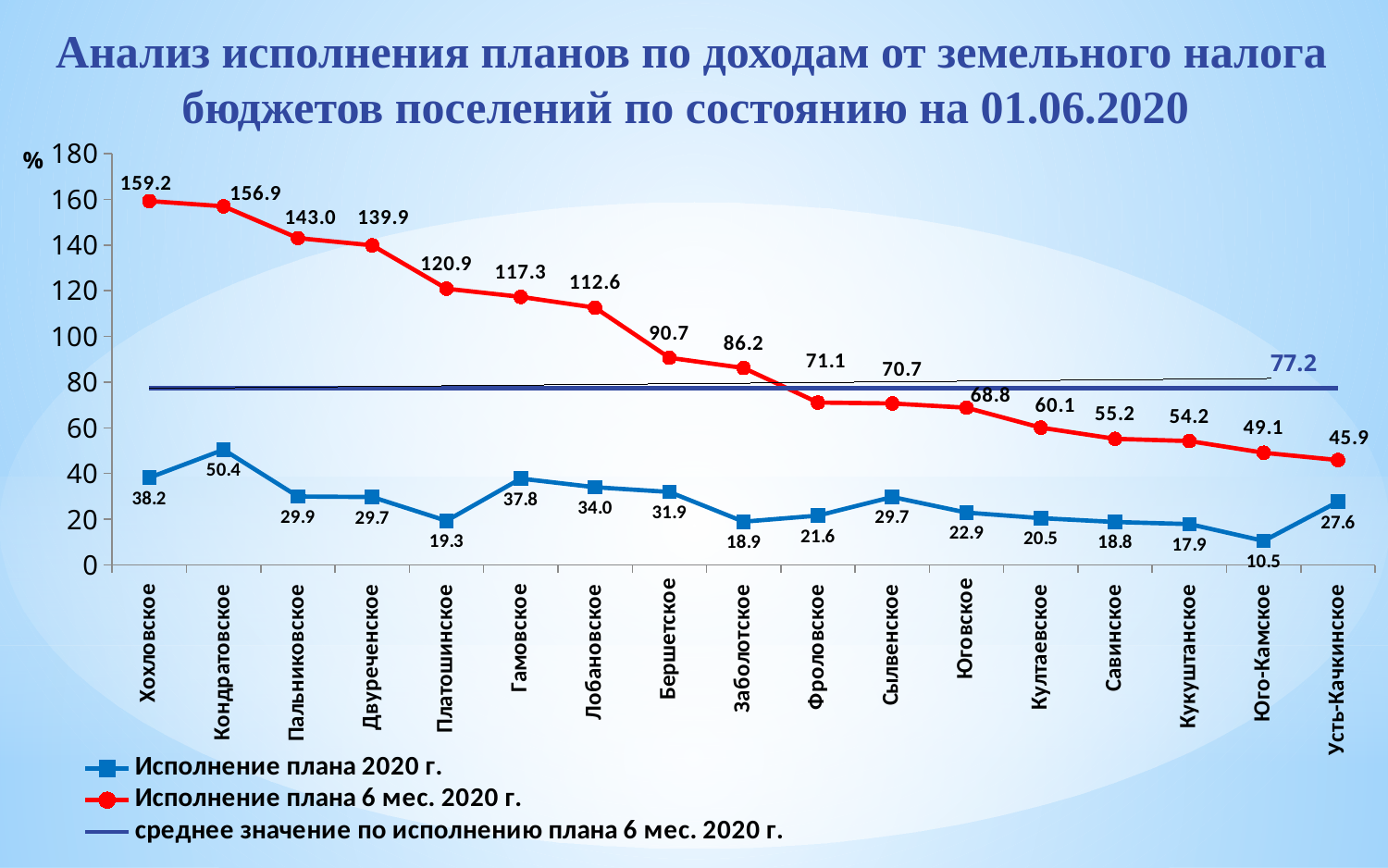
How many categories are shown on the x axis? 17 What is the value of the 'среднее значение по исполнению плана 6 мес. 2020 г.' line? 77.2 What is the value of the 'Исполнение плана 2020 г.' series for Юго-Камское? 10.5 Which category has the lowest value in the 'Исполнение плана 2020 г.' series? Юго-Камское Which category has the highest value in the 'Исполнение плана 2020 г.' series? Кондратовское In the 'Исполнение плана 6 мес. 2020 г.' series, which is larger: Гамовское or Лобановское? Гамовское What is the value of the 'Исполнение плана 6 мес. 2020 г.' series for Платошинское? 120.9 Which category has the highest value in the 'Исполнение плана 6 мес. 2020 г.' series? Хохловское What kind of chart is shown on the slide? Line chart How many series does the legend list? 3 What is the difference between the 'Исполнение плана 6 мес. 2020 г.' values for Хохловское and Усть-Качкинское? 113.3 Does the 'Исполнение плана 6 мес. 2020 г.' series rise or fall along the x axis from left to right? Falls